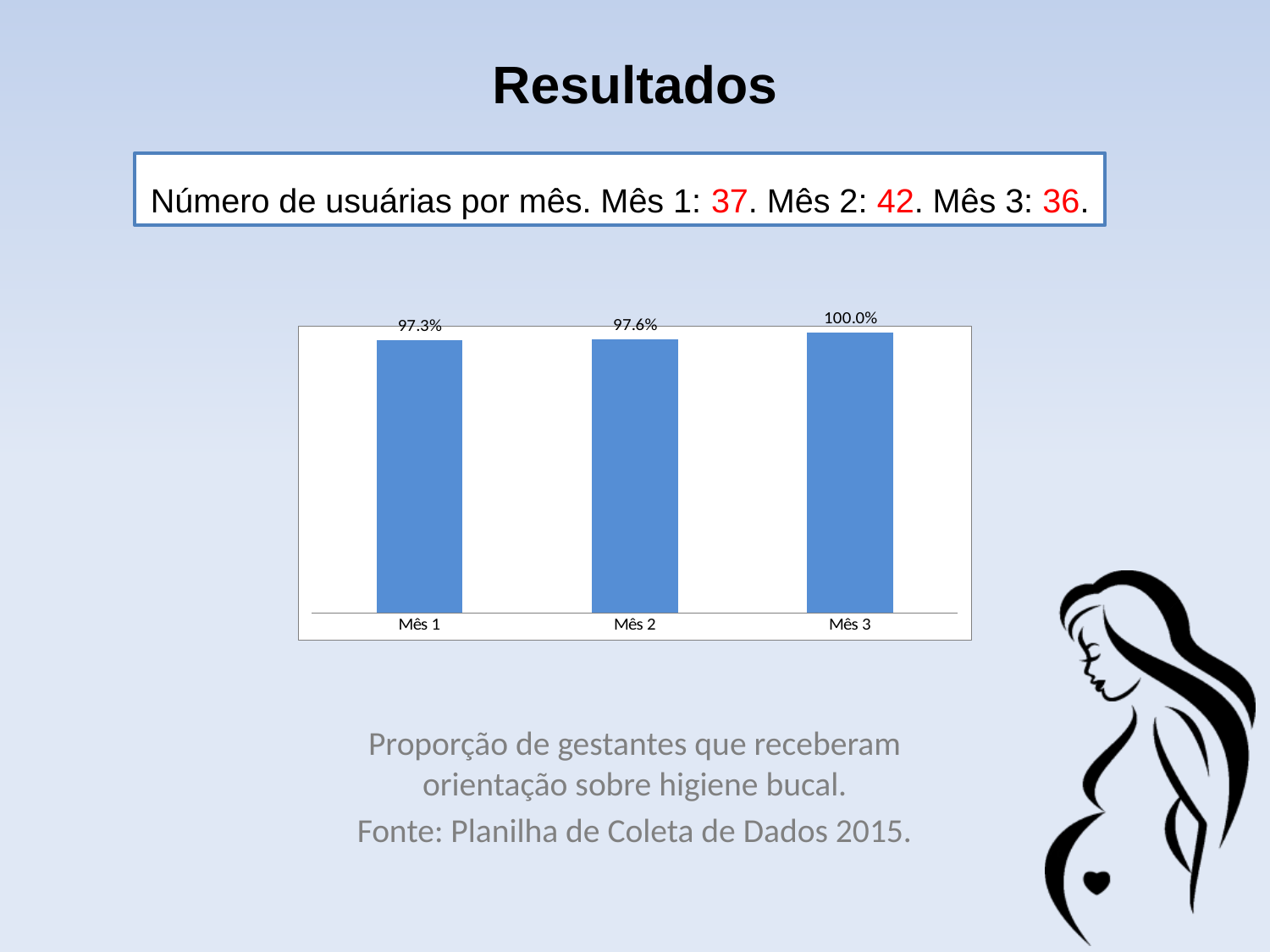
How many bars are shown in the chart? 3 Do the values rise or fall from Mês 1 to Mês 3? Rise What kind of chart is shown on the slide? Bar chart What is the value for Mês 3 in the bar chart? 100.0% What is the value for Mês 2 in the bar chart? 97.6% What is the difference between the values for Mês 3 and Mês 2? 2.4 percentage points What is the difference between the values for Mês 3 and Mês 1? 2.7 percentage points Which month has the highest value in the bar chart? Mês 3 What is the value for Mês 1 in the bar chart? 97.3% What colour are the bars in the chart? Blue What does the caption below the chart say the chart shows? Proporção de gestantes que receberam orientação sobre higiene bucal. Which is larger, the value for Mês 3 or the value for Mês 1? Mês 3